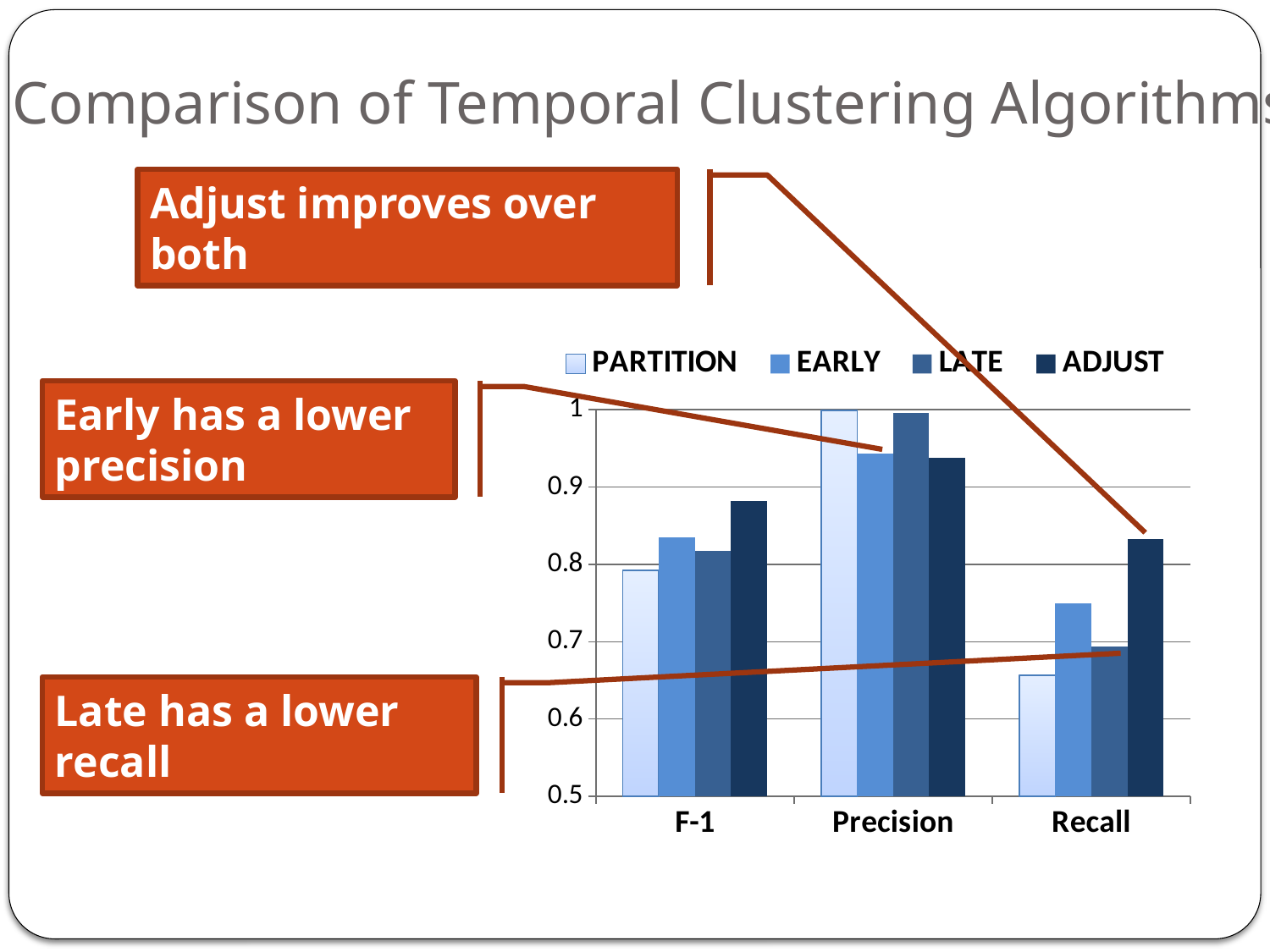
What kind of chart is shown on the slide? bar chart Which series has the highest value for F-1? ADJUST What is the title of the slide containing the chart? Comparison of Temporal Clustering Algorithms Which series has the lowest value for Recall? PARTITION For F-1, which is larger: PARTITION or ADJUST? ADJUST Is the PARTITION value for Recall greater or less than 0.7? less Which series has the highest value for Recall? ADJUST How many categories are shown on the x axis? 3 Is the ADJUST value for F-1 greater or less than 0.8? greater For Recall, which is larger: EARLY or LATE? EARLY How many series does the legend list? 4 Is the EARLY value for Precision greater or less than 0.9? greater